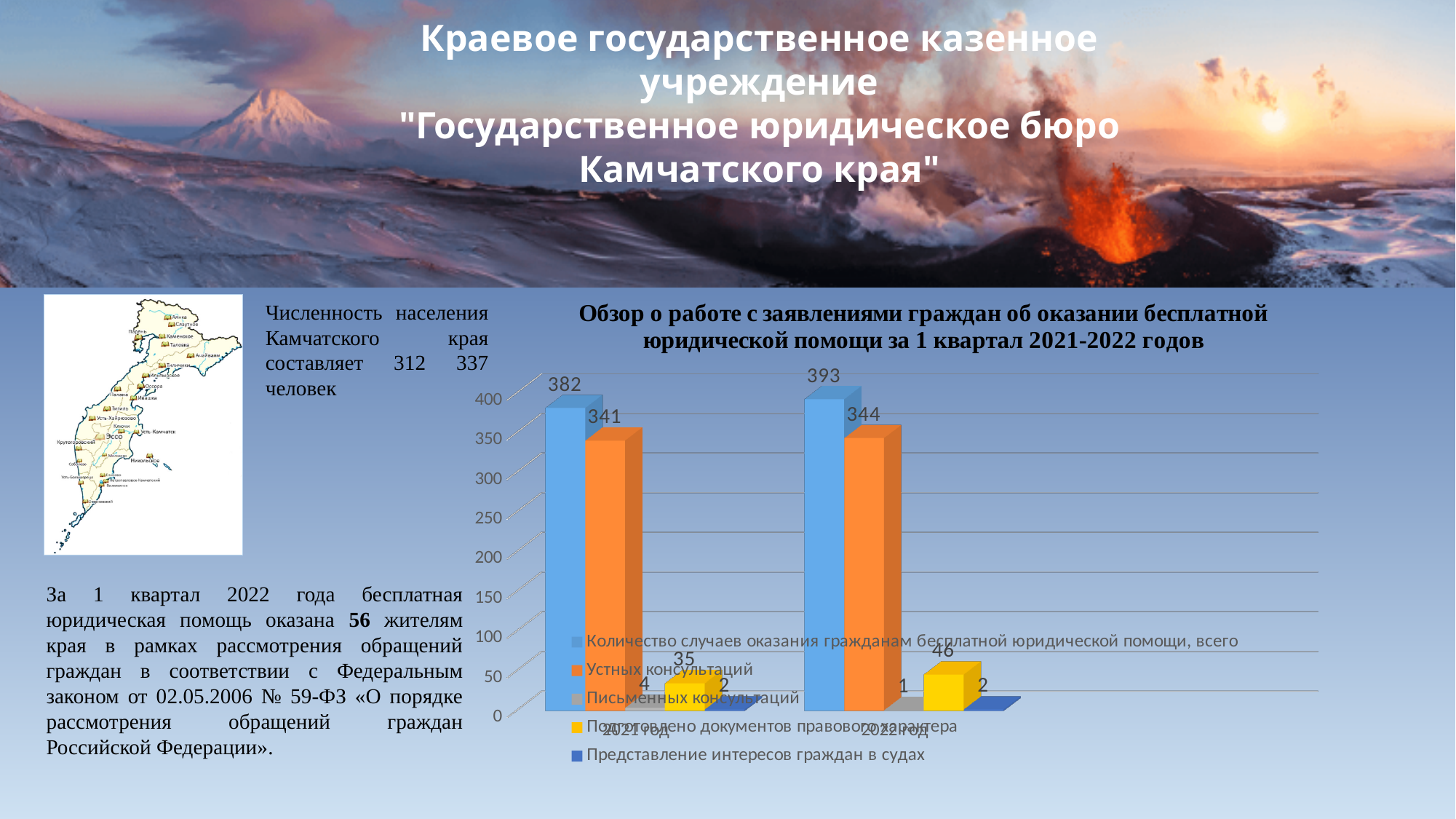
How many series does the legend list? 5 What is the title of the chart? Обзор о работе с заявлениями граждан об оказании бесплатной юридической помощи за 1 квартал 2021-2022 годов What is the value for 'Письменных консультаций' in 2022 год? 1 What is the difference between the total number of cases in 2022 год and 2021 год? 11 What is the value for 'Подготовлено документов правового характера' in 2021 год? 35 What is the value for 'Количество случаев оказания гражданам бесплатной юридической помощи, всего' in 2021 год? 382 Which is larger: 'Подготовлено документов правового характера' in 2021 год or in 2022 год? 2022 год What kind of chart is shown on the slide? Bar chart What is the value for 'Устных консультаций' in 2022 год? 344 Which series has the highest value in 2022 год? Количество случаев оказания гражданам бесплатной юридической помощи, всего Which series has the lowest value in 2021 год? Представление интересов граждан в судах How many categories are shown on the x axis? 2